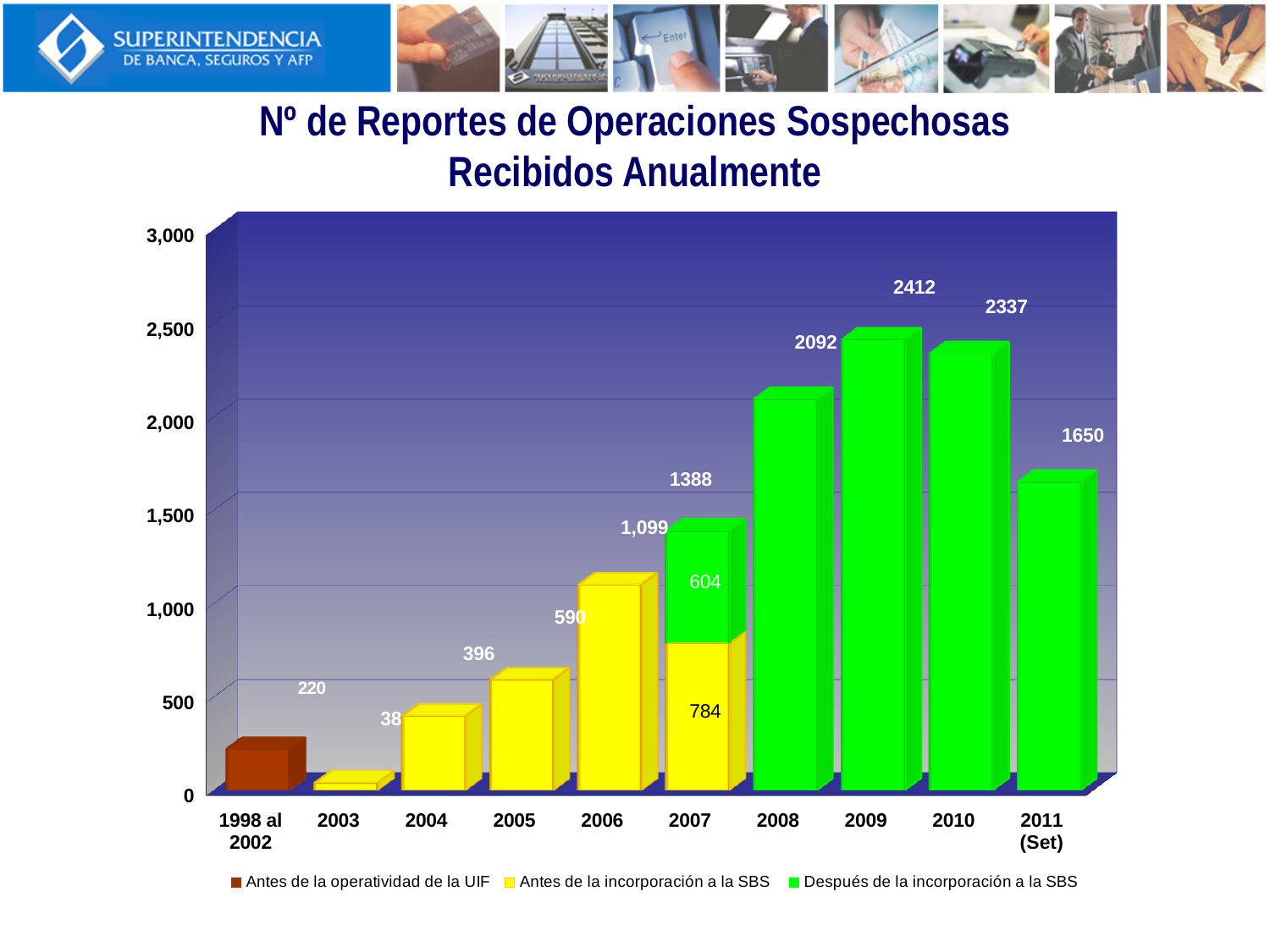
What is the value for 2009? 2412 What is the value for 2006? 1,099 Do the values rise or fall from 2003 to 2009? rise Which is larger, the value for 2008 or the value for 2010? 2010 Which category has the lowest value? 2003 Which year has the highest number of reports? 2009 What kind of chart is shown on the slide? bar chart What is the total of the stacked bar for 2007? 1388 How many categories are shown on the x axis? 10 What is the value of the 'Antes de la incorporación a la SBS' portion of the 2007 bar? 784 What is the difference between the values for 2009 and 2010? 75 How many series does the legend list? 3